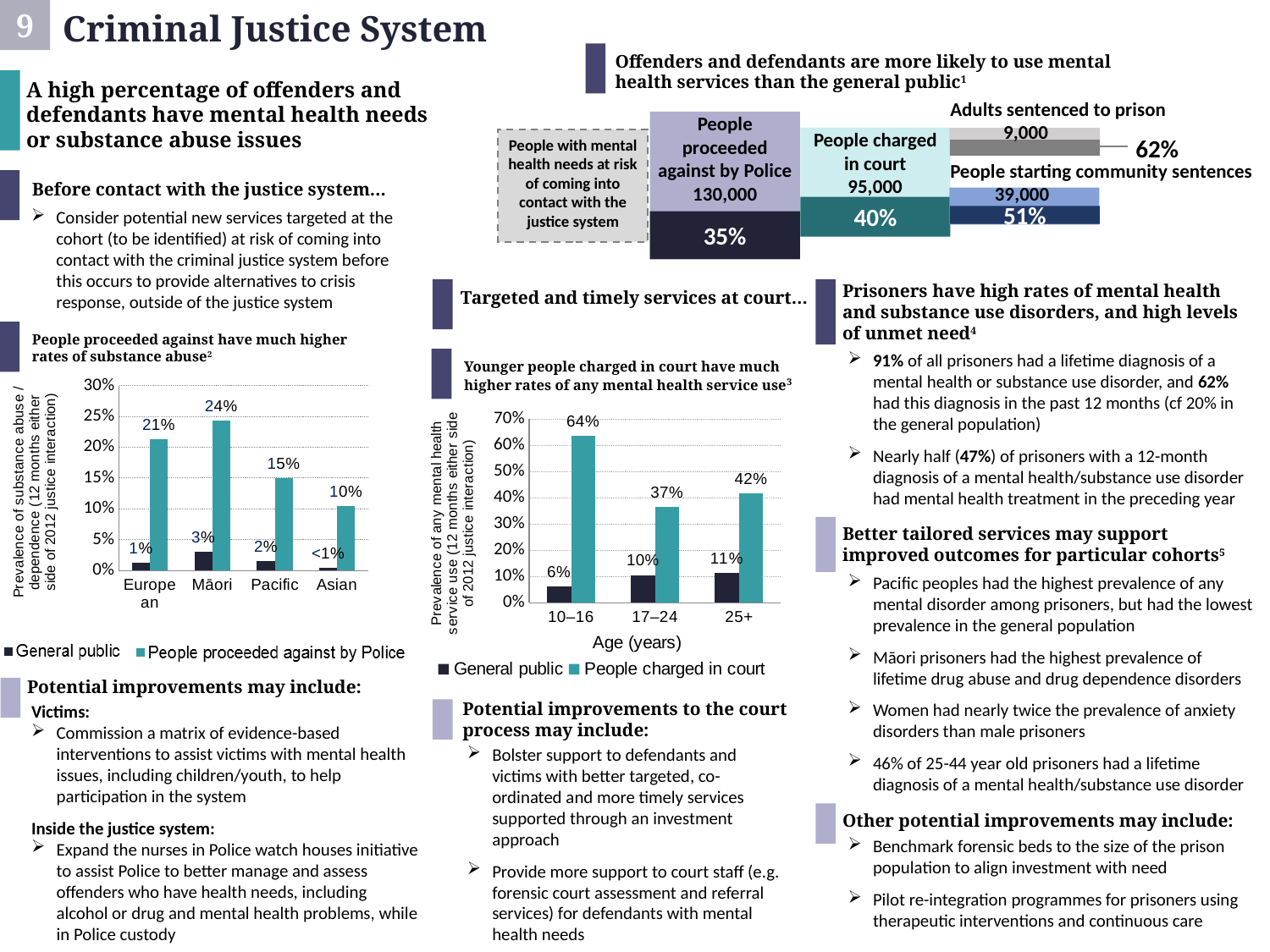
In the chart titled 'Younger people charged in court have much higher rates of any mental health service use', which is larger: the 'General public' value for 17–24 or for 10–16? 17–24 What type of chart is the one titled 'Younger people charged in court have much higher rates of any mental health service use'? Bar chart In the chart titled 'Younger people charged in court have much higher rates of any mental health service use', what is the difference between the 'People charged in court' values for 25+ and 17–24? 5% In the chart titled 'Younger people charged in court have much higher rates of any mental health service use', which age group has the highest 'People charged in court' value? 10–16 In the chart titled 'Younger people charged in court have much higher rates of any mental health service use', how many series does the legend list? 2 In the chart titled 'People proceeded against have much higher rates of substance abuse', how many ethnic categories are shown on the x axis? 4 In the chart titled 'People proceeded against have much higher rates of substance abuse', what is the value for Māori in the 'People proceeded against by Police' series? 24% In the chart titled 'People proceeded against have much higher rates of substance abuse', what is the difference between the 'People proceeded against by Police' values for European and Pacific? 6% In the chart titled 'People proceeded against have much higher rates of substance abuse', which category has the lowest value for 'People proceeded against by Police'? Asian In the chart titled 'People proceeded against have much higher rates of substance abuse', what is the 'General public' value for Māori? 3% In the chart titled 'People proceeded against have much higher rates of substance abuse', is the 'People proceeded against by Police' value for Pacific greater or less than 20%? less In the chart titled 'Younger people charged in court have much higher rates of any mental health service use', what is the value for the 10–16 age group in the 'People charged in court' series? 64%